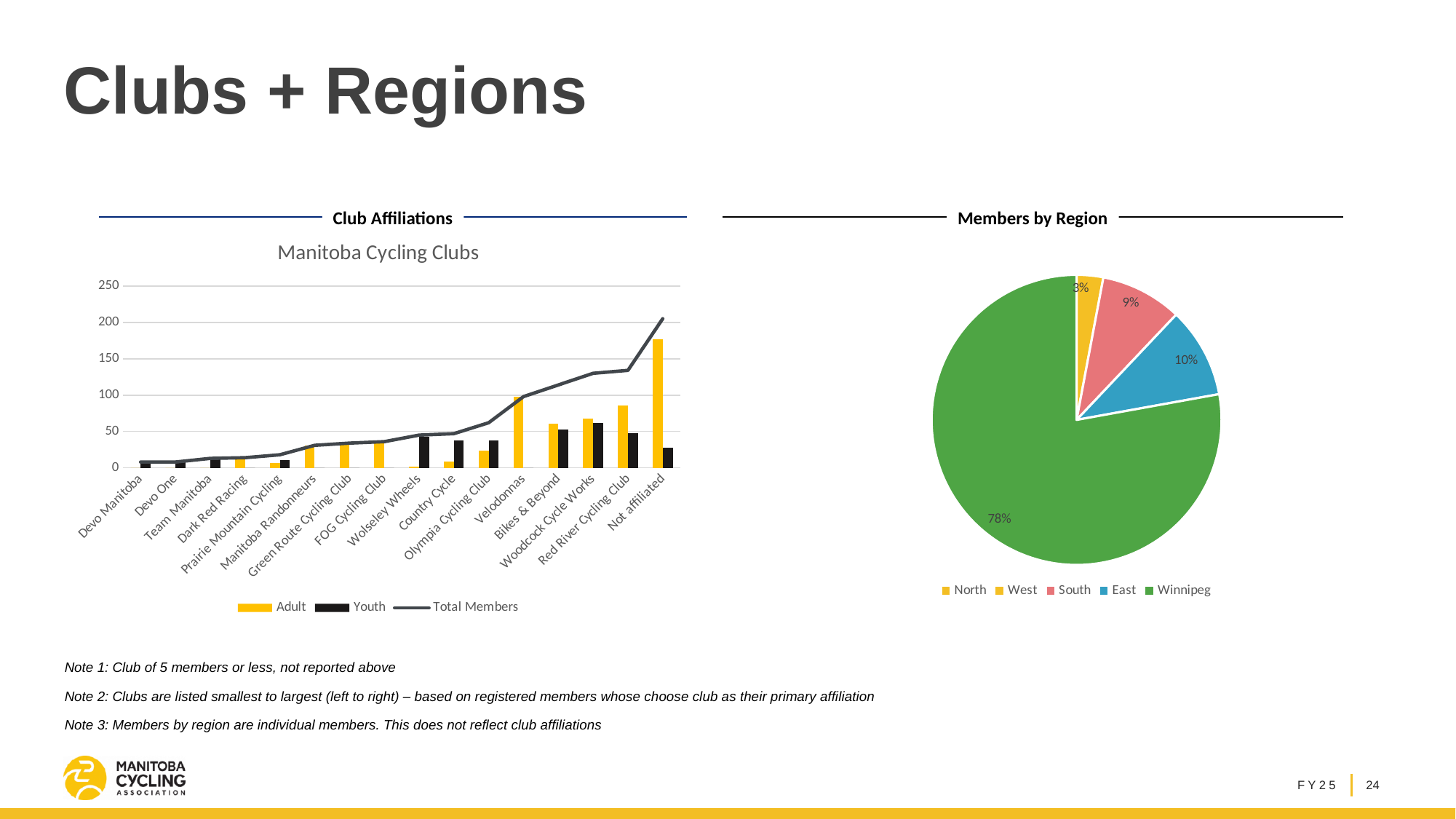
In the Members by Region pie chart, which region has the largest slice? Winnipeg In the Manitoba Cycling Clubs chart, is the Adult value for Velodonnas greater or less than 50? greater In the Members by Region pie chart, what share of members is Winnipeg? 78% How many regions does the legend of the Members by Region pie chart list? 5 In the Members by Region pie chart, what share of members is South? 9% How many series does the legend of the Manitoba Cycling Clubs chart list? 3 What kind of chart is the Manitoba Cycling Clubs chart on the left? combination bar and line chart In the Manitoba Cycling Clubs chart, is the Adult value for Not affiliated greater or less than 150? greater In the Members by Region pie chart, which is larger, East or South? East How many clubs (categories) are shown on the x axis of the Manitoba Cycling Clubs chart? 16 In the Manitoba Cycling Clubs chart, does the Total Members line rise or fall from left to right? rise In the Members by Region pie chart, what share of members is East? 10%